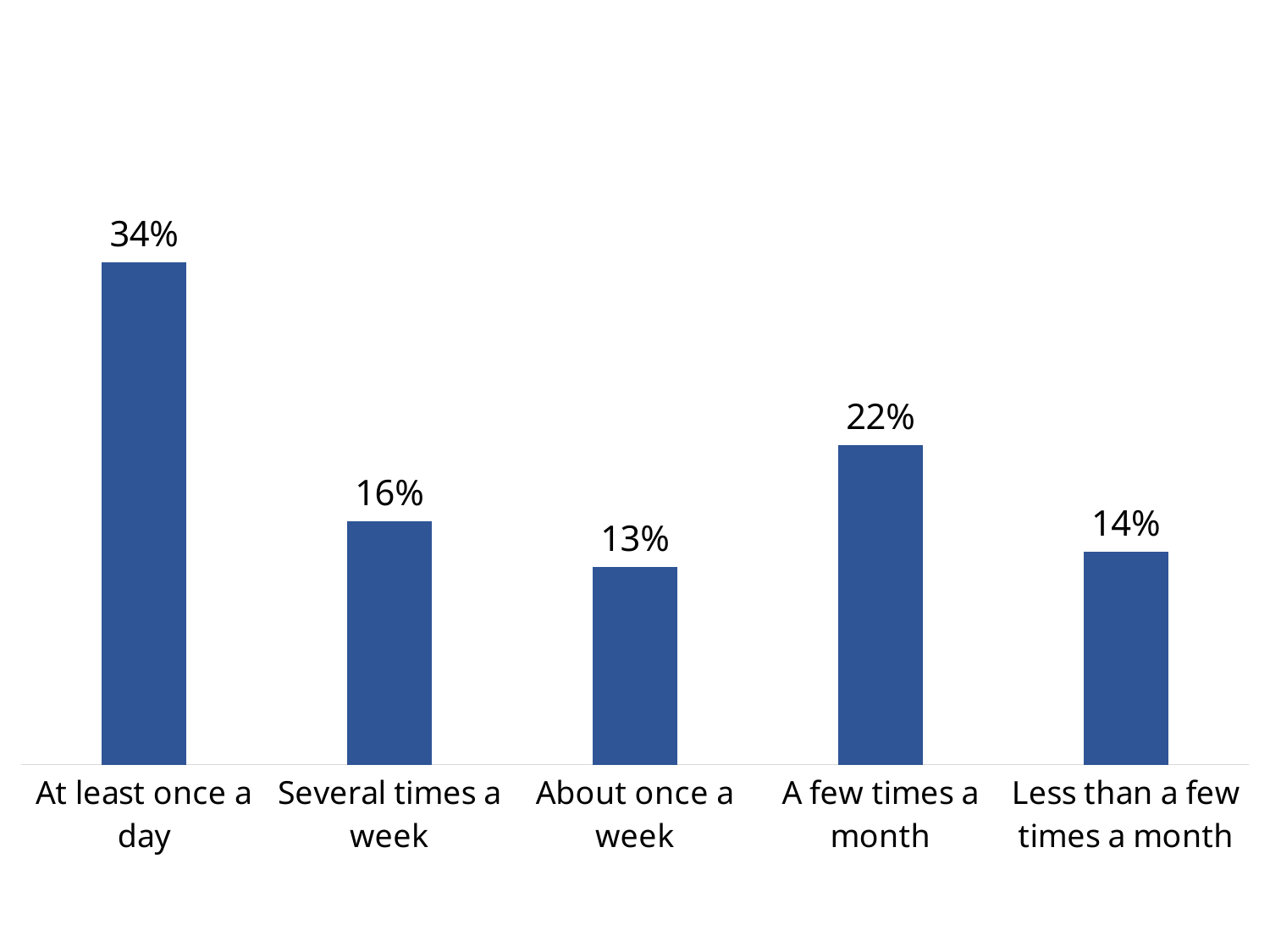
Which category has the lowest value? About once a week What is the value for "A few times a month"? 22% Which category has the highest value? At least once a day What is the value for "About once a week"? 13% What colour are the bars in the chart? Blue What is the value for "At least once a day"? 34% What is the value for "Several times a week"? 16% How many categories are shown on the chart? 5 What is the value for "Less than a few times a month"? 14% What is the difference between the values for "At least once a day" and "A few times a month"? 12% What kind of chart is shown on the slide? Bar chart Which is larger, the value for "Several times a week" or the value for "Less than a few times a month"? Several times a week